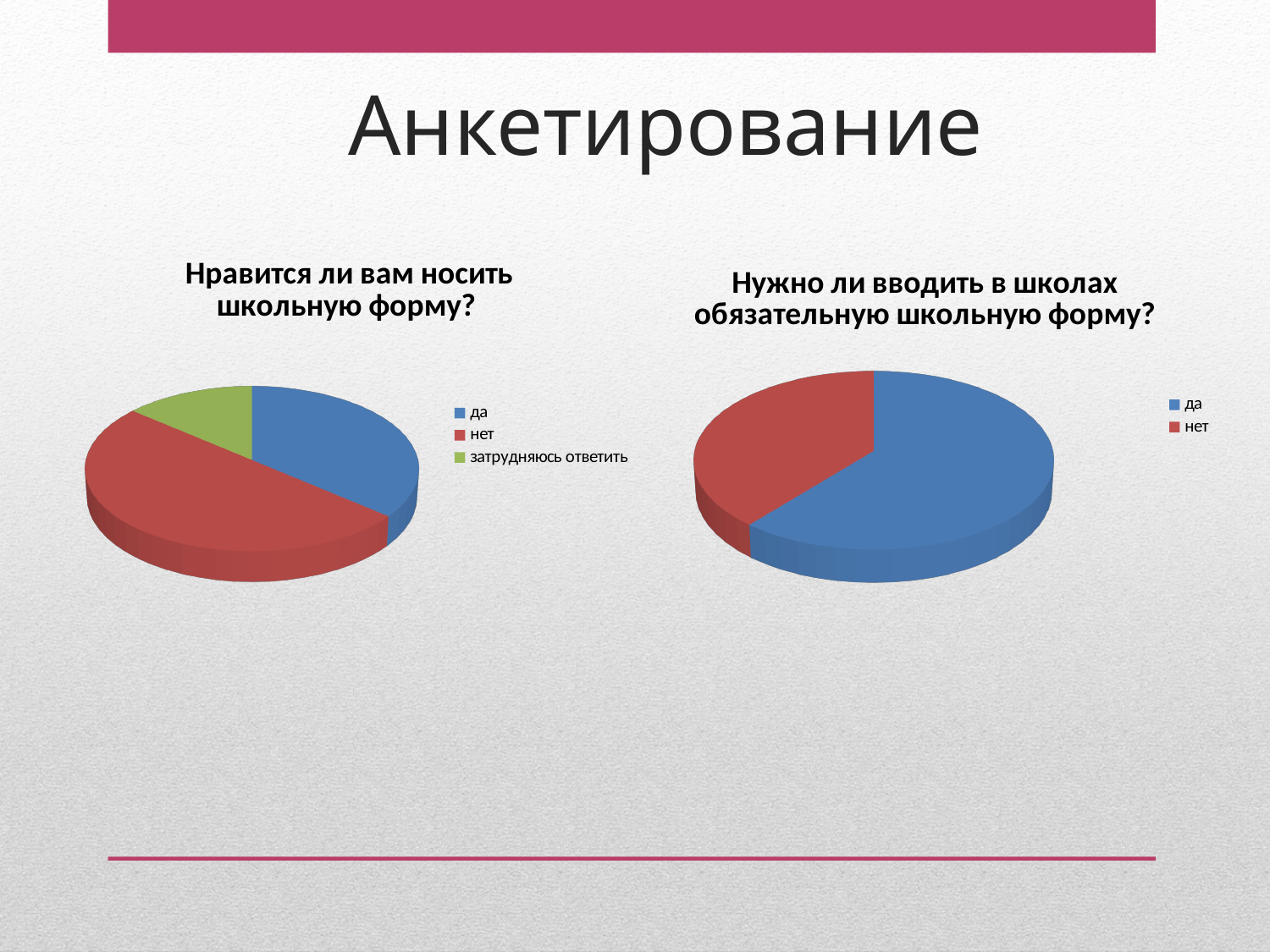
In the left chart "Нравится ли вам носить школьную форму?", which slice is larger: "да" or "нет"? нет In the right chart "Нужно ли вводить в школах обязательную школьную форму?", which category has the largest slice? да How many categories does the legend of the left chart "Нравится ли вам носить школьную форму?" list? 3 In the right chart "Нужно ли вводить в школах обязательную школьную форму?", which slice is smaller: "да" or "нет"? нет In the left chart "Нравится ли вам носить школьную форму?", which category has the largest slice? нет What is the title of the slide containing the two pie charts? Анкетирование What type of chart is the left chart titled "Нравится ли вам носить школьную форму?"? Pie chart What type of chart is the right chart titled "Нужно ли вводить в школах обязательную школьную форму?"? Pie chart In the left chart "Нравится ли вам носить школьную форму?", which category has the smallest slice? затрудняюсь ответить In the left chart "Нравится ли вам носить школьную форму?", which slice is larger: "да" or "затрудняюсь ответить"? да In the left chart "Нравится ли вам носить школьную форму?", what colour represents "затрудняюсь ответить"? Green How many slices does the right chart "Нужно ли вводить в школах обязательную школьную форму?" have? 2